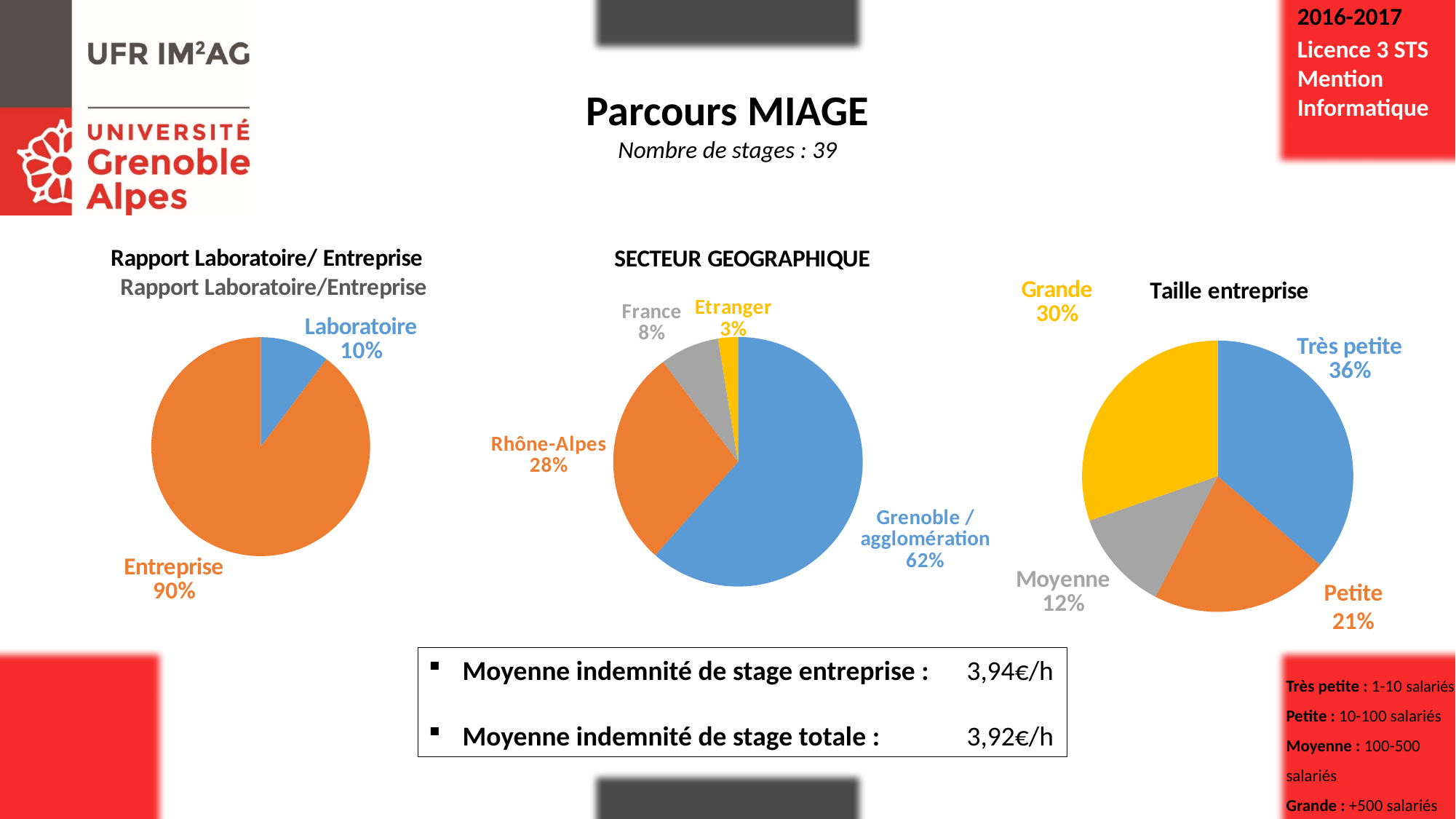
In the 'Taille entreprise' pie chart, which category has the largest share? Très petite In the 'SECTEUR GEOGRAPHIQUE' pie chart, what share is labelled for Grenoble / agglomération? 62% In the 'SECTEUR GEOGRAPHIQUE' pie chart, how many categories are shown? 4 What type of chart is the 'Taille entreprise' chart? Pie chart In the 'Taille entreprise' pie chart, what is the difference in percentage points between Très petite and Petite? 15 In the 'SECTEUR GEOGRAPHIQUE' pie chart, what is the difference in percentage points between Rhône-Alpes and France? 20 In the 'Taille entreprise' pie chart, what share is labelled for Moyenne? 12% In the 'Taille entreprise' pie chart, what colour is the Grande slice? Yellow In the 'Rapport Laboratoire/Entreprise' pie chart, what share is labelled for Laboratoire? 10% In the 'SECTEUR GEOGRAPHIQUE' pie chart, which category has the smallest share? Etranger In the 'Taille entreprise' pie chart, which is larger, Grande or Petite? Grande In the 'Rapport Laboratoire/Entreprise' pie chart, what share is labelled for Entreprise? 90%